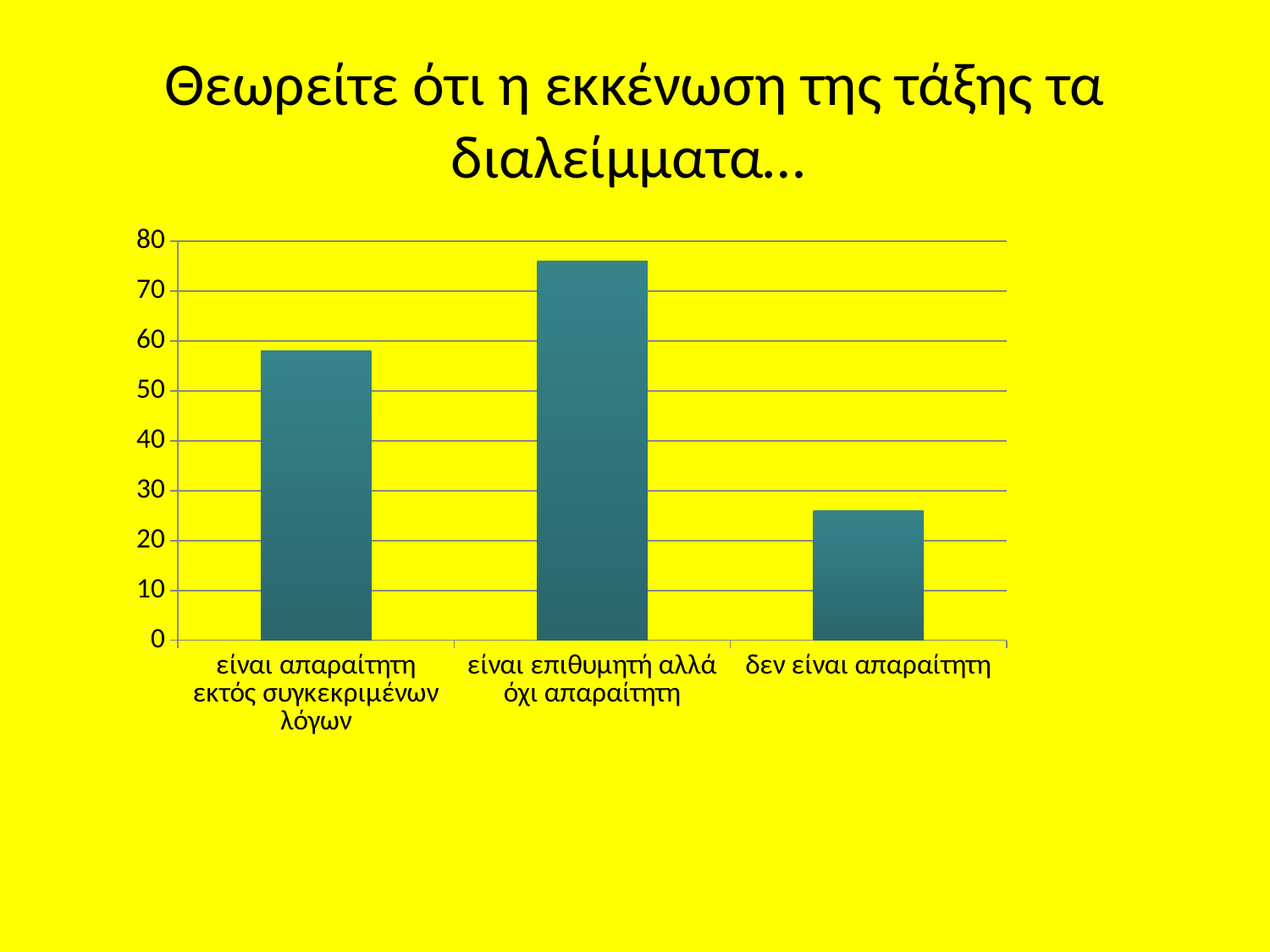
Is the value for 'είναι απαραίτητη εκτός συγκεκριμένων λόγων' greater or less than 50? greater Which category has the highest bar? είναι επιθυμητή αλλά όχι απαραίτητη Is the value for 'είναι επιθυμητή αλλά όχι απαραίτητη' greater or less than 70? greater Which is larger: the value for 'είναι επιθυμητή αλλά όχι απαραίτητη' or the value for 'είναι απαραίτητη εκτός συγκεκριμένων λόγων'? είναι επιθυμητή αλλά όχι απαραίτητη Is the value for 'είναι επιθυμητή αλλά όχι απαραίτητη' greater or less than 80? less Which is larger: the value for 'είναι απαραίτητη εκτός συγκεκριμένων λόγων' or the value for 'δεν είναι απαραίτητη'? είναι απαραίτητη εκτός συγκεκριμένων λόγων Which category has the lowest bar? δεν είναι απαραίτητη What is the title of the slide above the chart? Θεωρείτε ότι η εκκένωση της τάξης τα διαλείμματα... How many categories are shown on the x axis of the chart? 3 What kind of chart is shown on the slide? bar chart